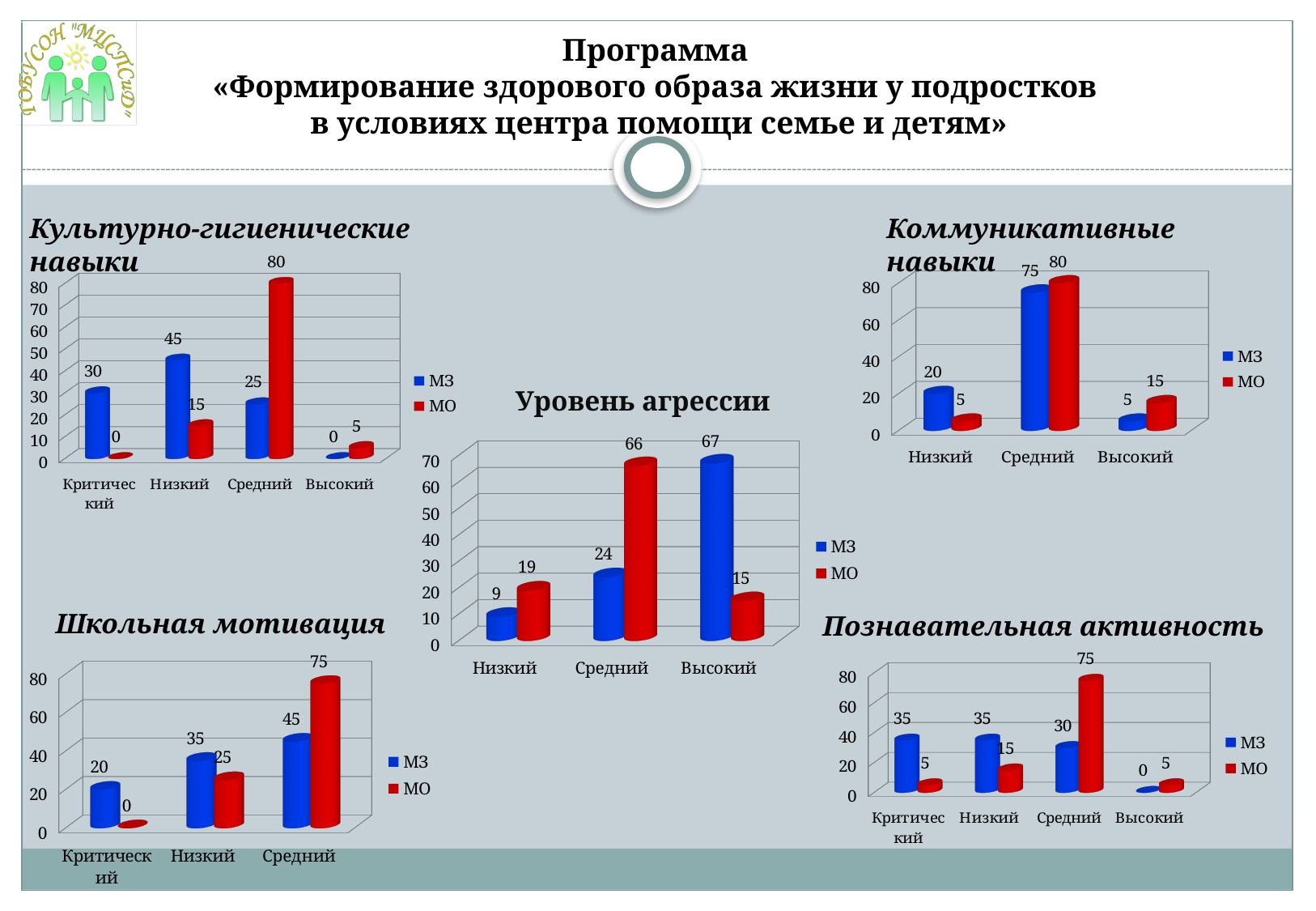
In the 'Уровень агрессии' chart, which is larger for Низкий: МЗ or МО? МО How many categories are shown on the x axis of the 'Школьная мотивация' chart? 3 In the 'Уровень агрессии' chart, what is the МЗ value for Высокий? 67 In the 'Школьная мотивация' chart, what is the МО value for Критический? 0 What type of chart is the 'Уровень агрессии' chart? Bar chart In the 'Познавательная активность' chart, what is the difference between the МО and МЗ values for Средний? 45 In the 'Коммуникативные навыки' chart, what is the МЗ value for Средний? 75 How many series does the legend of the 'Познавательная активность' chart list? 2 In the 'Культурно-гигиенические навыки' chart, what is the МО value for Средний? 80 In the 'Уровень агрессии' chart, what is the difference between the МО and МЗ values for Средний? 42 In the 'Коммуникативные навыки' chart, which category has the lowest МО value? Низкий In the 'Культурно-гигиенические навыки' chart, which category has the highest МЗ value? Низкий